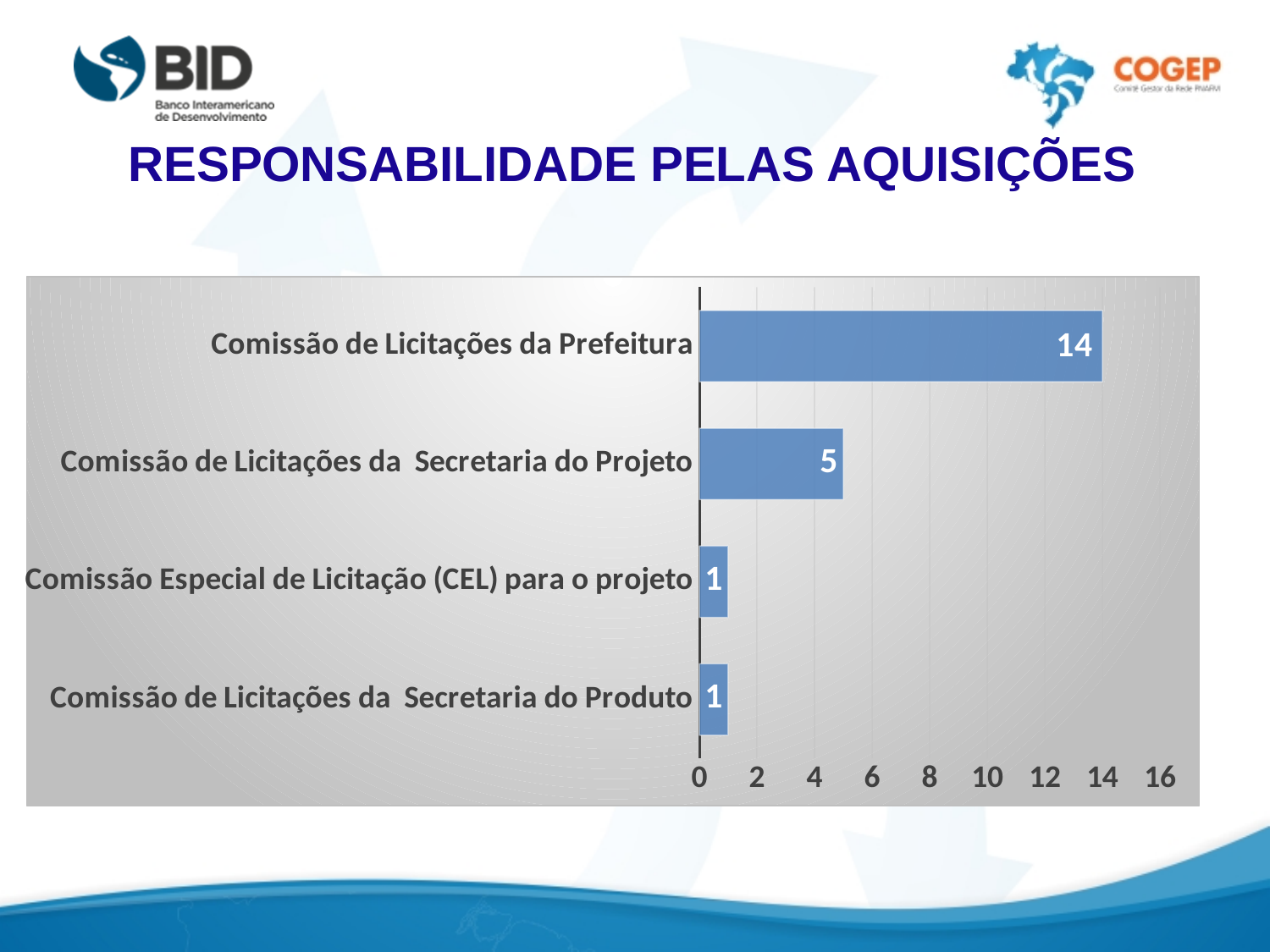
What is the difference between the values for Comissão de Licitações da Prefeitura and Comissão de Licitações da Secretaria do Projeto? 9 What is the value for Comissão de Licitações da Prefeitura? 14 Which is larger: the value for Comissão de Licitações da Secretaria do Projeto or the value for Comissão de Licitações da Secretaria do Produto? Comissão de Licitações da Secretaria do Projeto What is the title of the slide above the chart? RESPONSABILIDADE PELAS AQUISIÇÕES What kind of chart is shown on the slide? bar chart What is the value for Comissão Especial de Licitação (CEL) para o projeto? 1 How many categories are shown in the chart? 4 Is the value for Comissão de Licitações da Prefeitura greater or less than 10? greater What is the value for Comissão de Licitações da Secretaria do Projeto? 5 Which category has the highest value? Comissão de Licitações da Prefeitura What is the difference between the values for Comissão de Licitações da Secretaria do Projeto and Comissão Especial de Licitação (CEL) para o projeto? 4 What is the value for Comissão de Licitações da Secretaria do Produto? 1